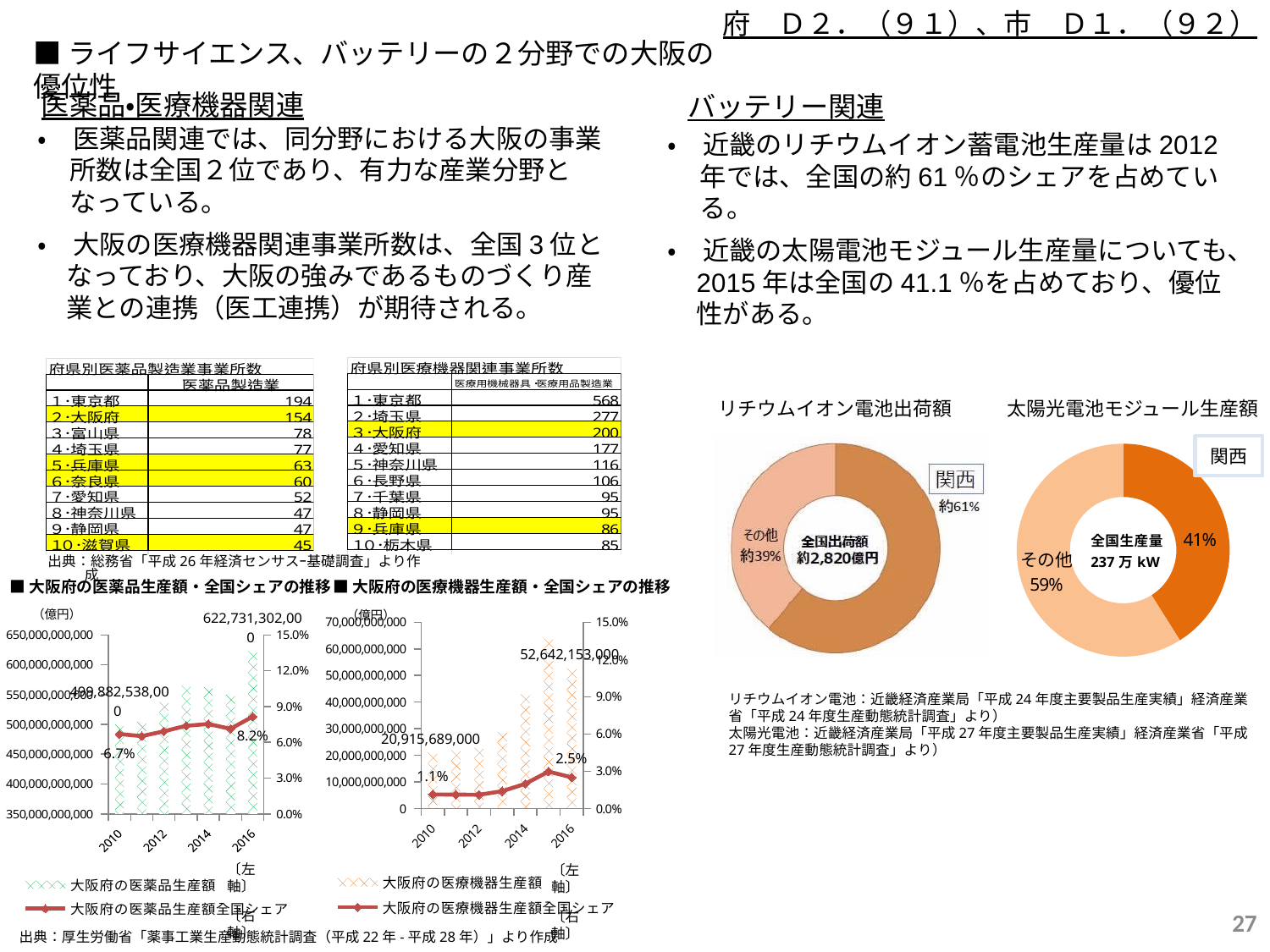
In the 大阪府の医薬品生産額・全国シェアの推移 chart, what is the difference between the 2016 share (8.2%) and the 2010 share (6.7%)? 1.5 percentage points In the 大阪府の医療機器生産額・全国シェアの推移 chart, does the 全国シェア line rise or fall from 2010 to 2016? rise In the 大阪府の医薬品生産額・全国シェアの推移 chart, what is the 全国シェア value labelled for 2016? 8.2% In the リチウムイオン電池出荷額 chart, what share does 関西 hold? 約61% In the 太陽光電池モジュール生産額 chart, what share does 関西 hold? 41% In the リチウムイオン電池出荷額 chart, what share does その他 hold? 約39% In the 太陽光電池モジュール生産額 chart, what is the 全国生産量 shown in the centre? 237万kW How many series does the legend of the 大阪府の医薬品生産額・全国シェアの推移 chart list? 2 In the 太陽光電池モジュール生産額 chart, which slice is larger, 関西 or その他? その他 In the リチウムイオン電池出荷額 chart, what is the 全国出荷額 shown in the centre? 約2,820億円 What kind of chart is the リチウムイオン電池出荷額 chart? pie (donut) chart In the 大阪府の医療機器生産額・全国シェアの推移 chart, what is the 全国シェア value labelled for 2010? 1.1%